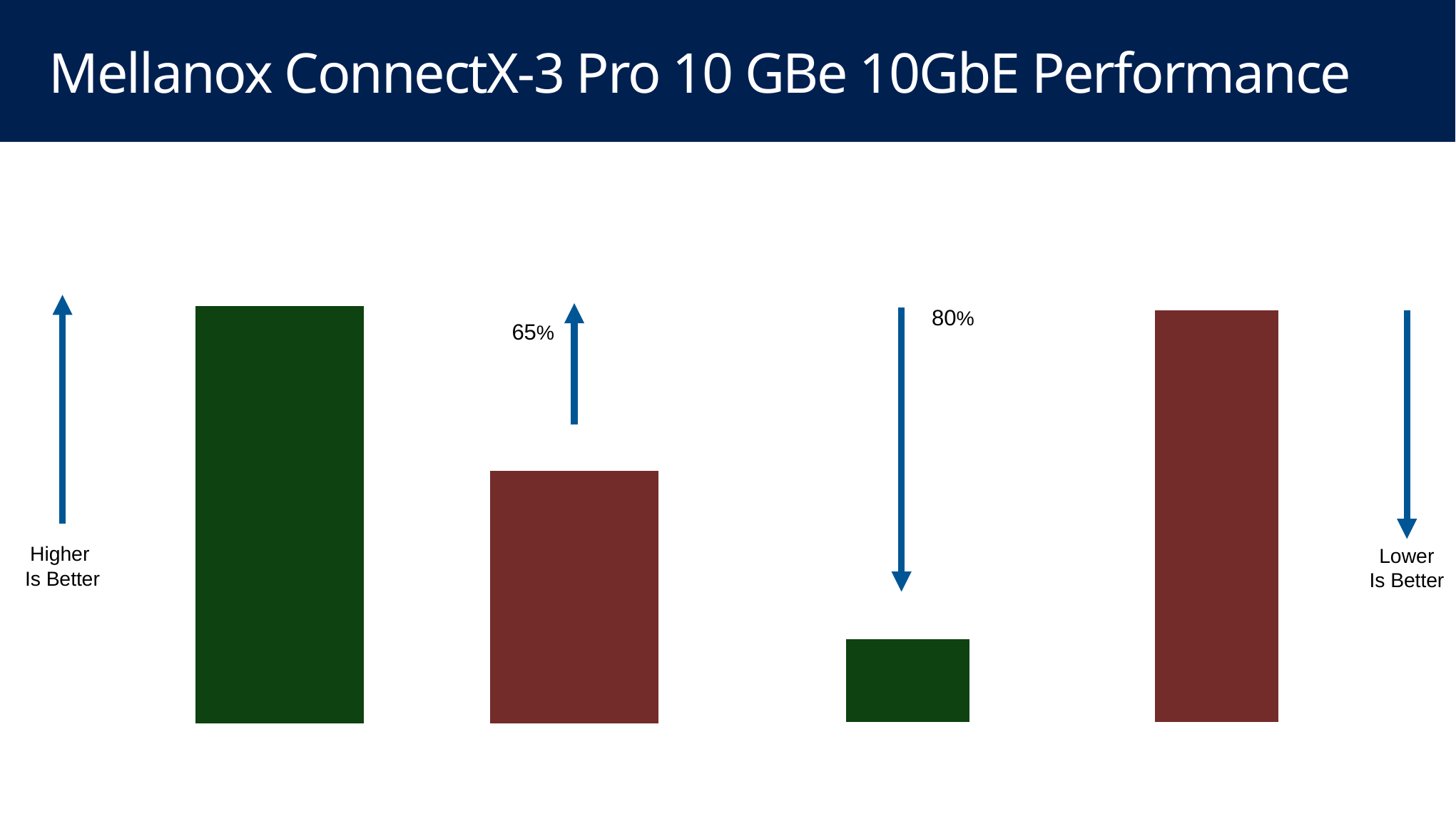
In the right chart (labelled 'Lower Is Better'), which bar is the shortest, the green bar or the red bar? green bar In the left chart (labelled 'Higher Is Better'), which bar is taller, the green bar or the red bar? green bar In the left chart (labelled 'Higher Is Better'), which bar is the tallest, the green bar or the red bar? green bar What text is written beside the upward arrow on the far left of the slide? Higher Is Better What kind of chart is shown on the left side of the slide? bar chart How many bars are plotted in total across both charts on the slide? 4 In the left chart (labelled 'Higher Is Better'), how many bars are plotted? 2 In the right chart (labelled 'Lower Is Better'), how many bars are plotted? 2 In the left chart (labelled 'Higher Is Better'), what percentage is printed next to the upward arrow between the bars? 65% In the right chart (labelled 'Lower Is Better'), what percentage is printed next to the downward arrow between the bars? 80% What text is written beside the downward arrow on the far right of the slide? Lower Is Better In the right chart (labelled 'Lower Is Better'), which bar is taller, the green bar or the red bar? red bar